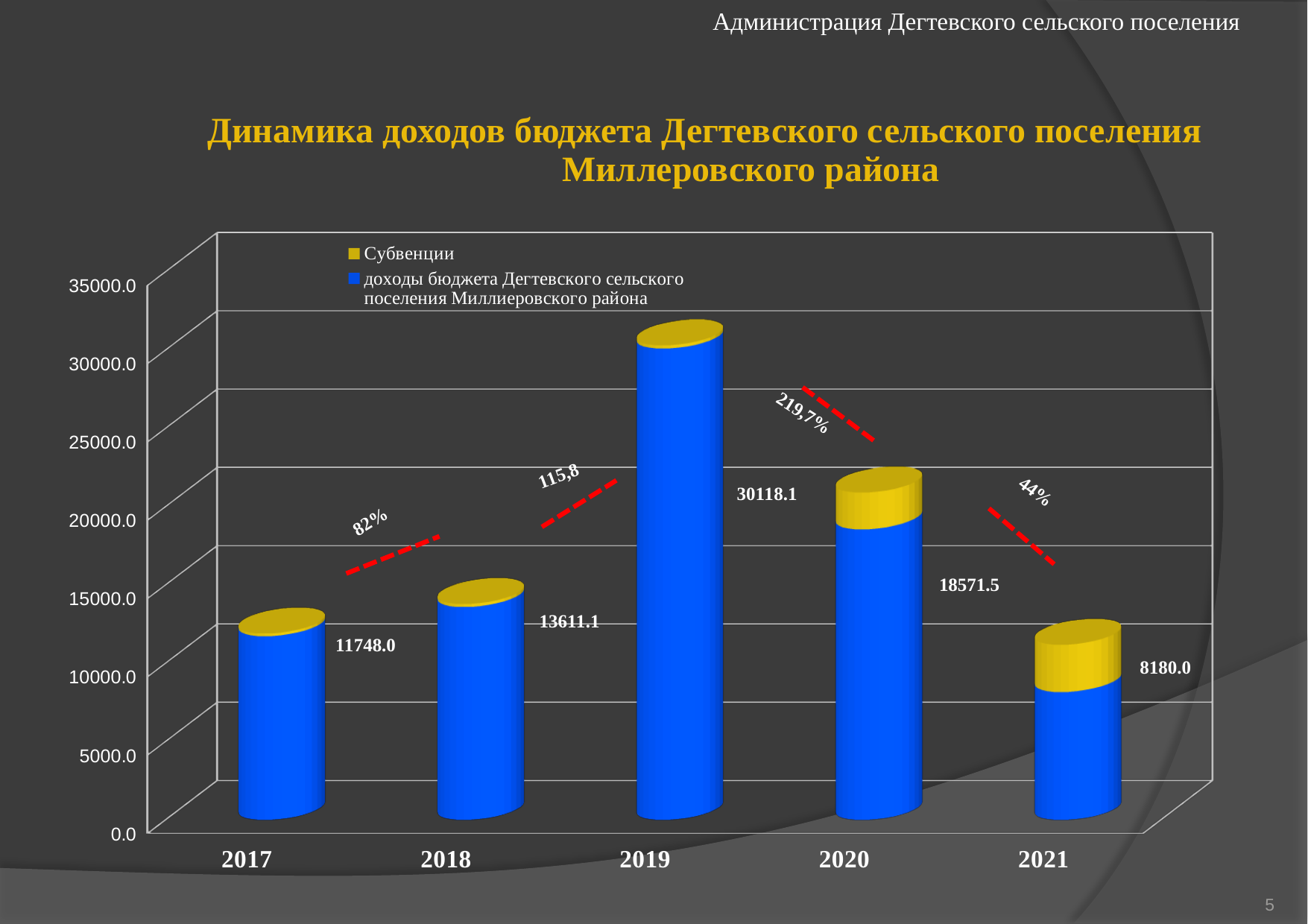
What is the value of the budget revenues (доходы бюджета) series for 2017? 11748.0 What is the difference between the budget revenues values for 2019 and 2018? 16507.0 What kind of chart is shown on the slide? bar chart How many series does the legend list? 2 What is the value of the budget revenues (доходы бюджета) series for 2019? 30118.1 Which year has the highest budget revenues value? 2019 Which year has the larger budget revenues value, 2018 or 2020? 2020 What is the value of the budget revenues (доходы бюджета) series for 2021? 8180.0 What is the value of the budget revenues (доходы бюджета) series for 2020? 18571.5 Which year has the lowest budget revenues value? 2021 Which colour represents the Субвенции series in the legend? yellow How many years are shown on the x axis? 5